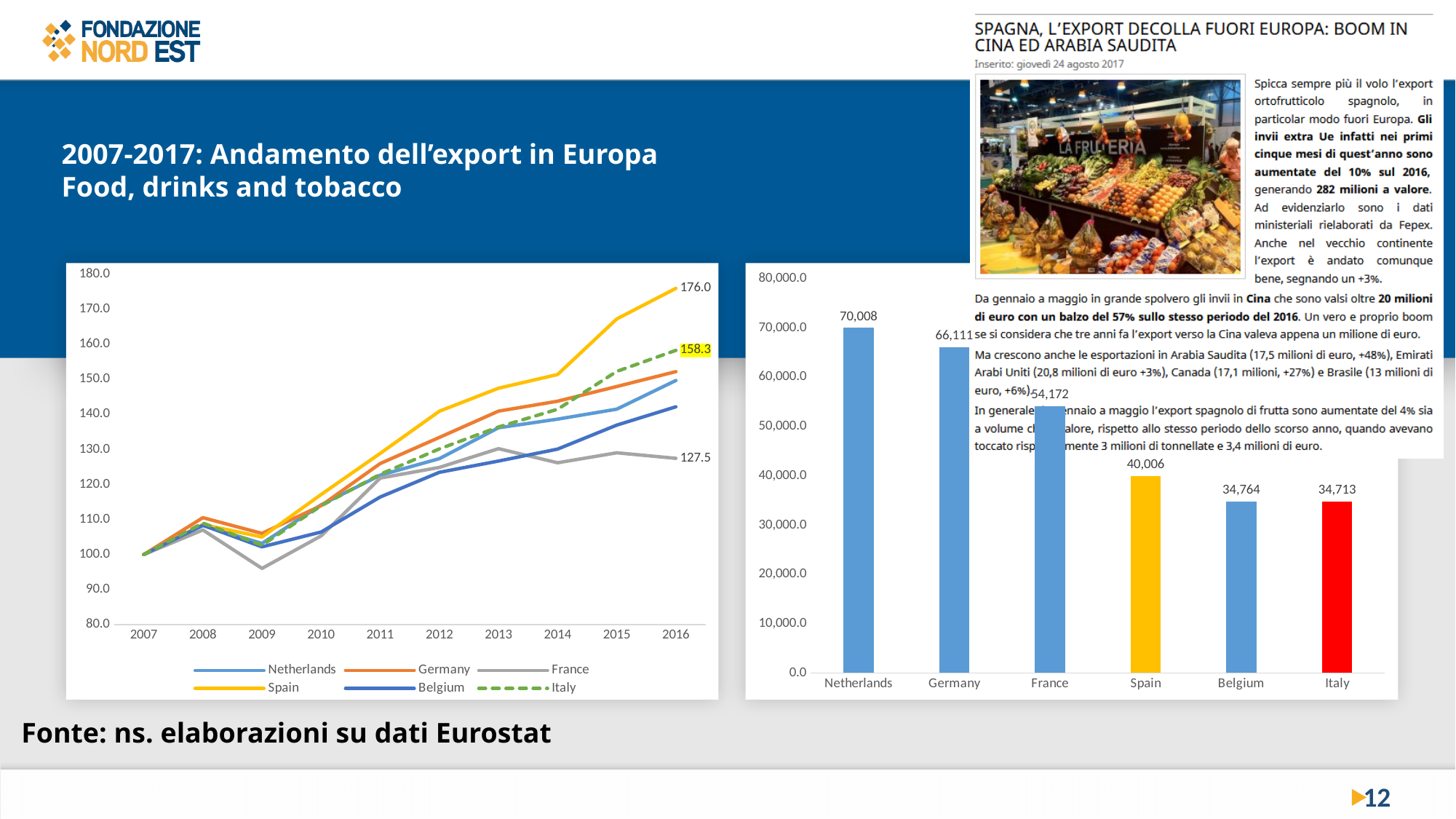
What kind of chart is the chart on the right? bar chart On the left line chart, what is the difference between the 2016 values for Spain and Italy? 17.7 On the left line chart, does the Spain series rise or fall from 2007 to 2016? rise On the right bar chart, what is the difference between the values for Netherlands and Germany? 3,897 On the left line chart, what is the value for Spain in 2016? 176.0 On the right bar chart, what is the value for Netherlands? 70,008 On the left line chart, how many series does the legend list? 6 On the left line chart, is the value for Belgium in 2016 greater or less than 140? greater On the left line chart, what is the value for Italy in 2016? 158.3 On the right bar chart, which country has the highest value? Netherlands On the left line chart, what is the value for France in 2016? 127.5 On the right bar chart, which is larger, the value for France or the value for Spain? France